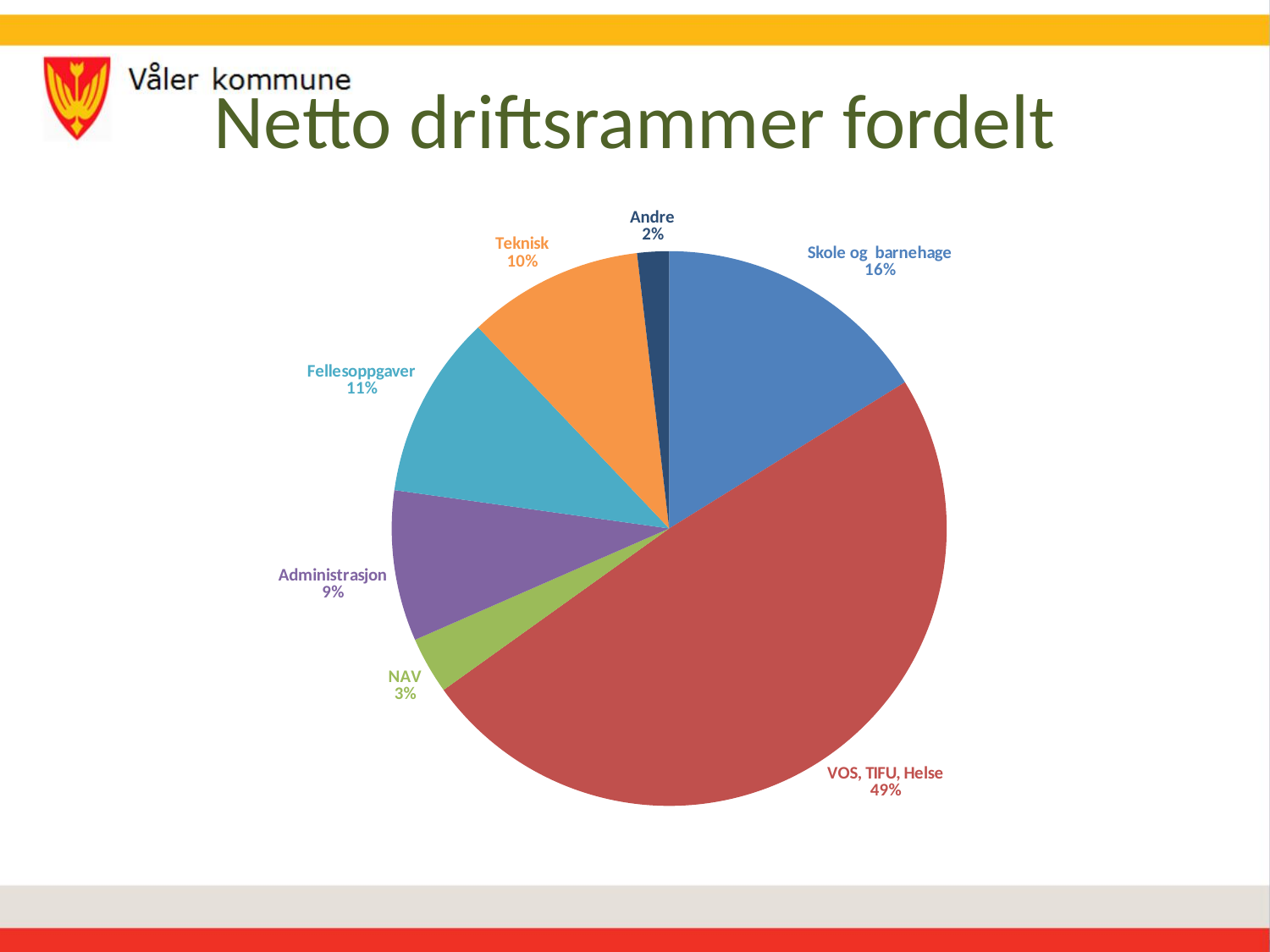
What is the value shown for Fellesoppgaver? 11% How many categories are shown in the pie chart? 7 What type of chart is shown on the slide? pie chart What share of the pie does VOS, TIFU, Helse have? 49% Which category has the largest slice of the pie? VOS, TIFU, Helse What is the title of the chart on the slide? Netto driftsrammer fordelt What share of the pie does Skole og barnehage have? 16% Which category has the smallest slice of the pie? Andre What is the value shown for Teknisk? 10% What is the value shown for Administrasjon? 9% Which is larger, the slice for NAV or the slice for Administrasjon? Administrasjon What is the difference in percentage points between VOS, TIFU, Helse and Skole og barnehage? 33